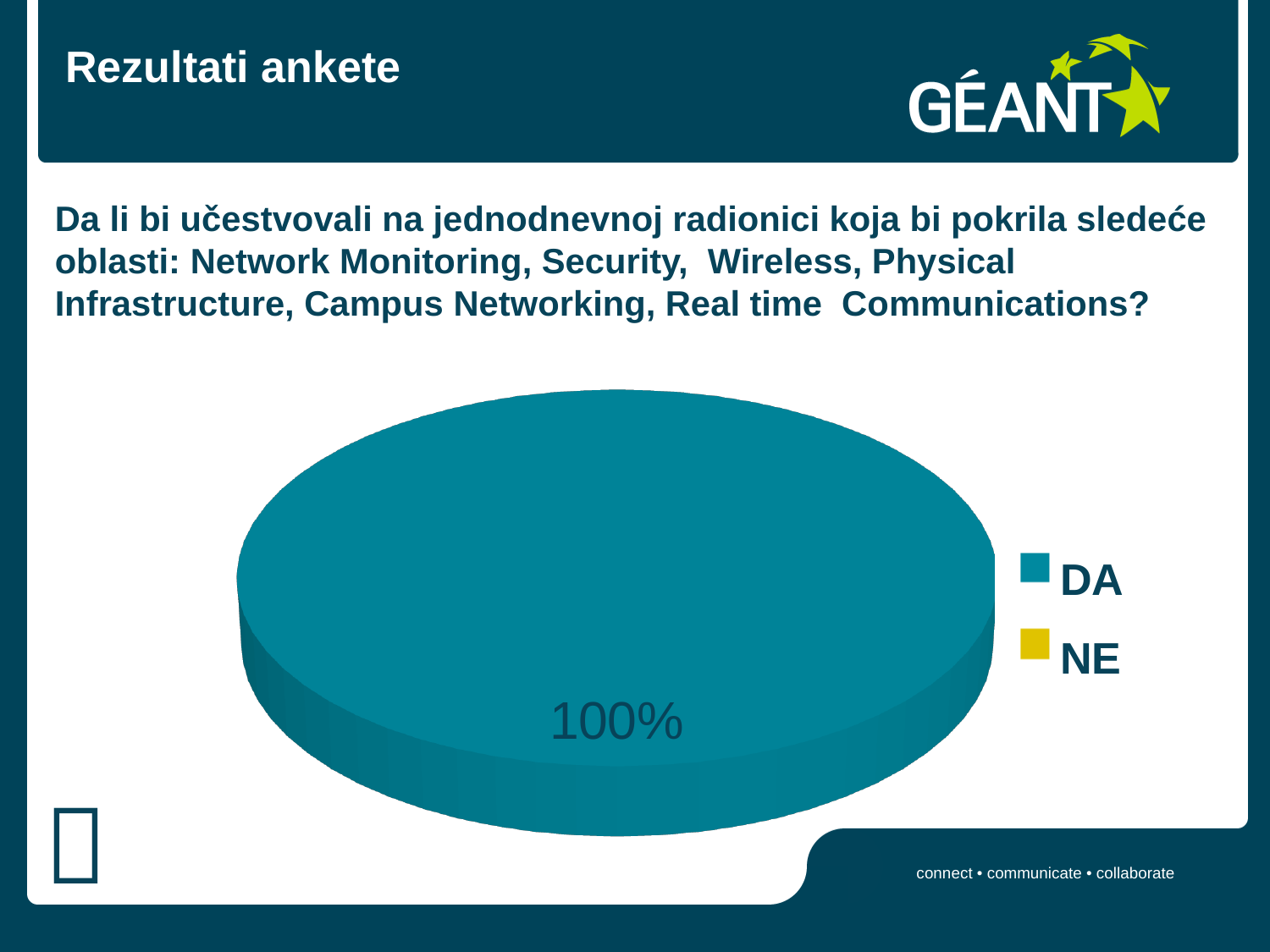
What colour is used for the NE category in the legend? yellow Which category has the largest share of the pie? DA What share of the pie does the DA category have? 100% Which is larger, the share for DA or the share for NE? DA What kind of chart is shown on the slide? pie chart How many categories does the legend list? 2 What percentage label is printed on the pie? 100% What colour is used for the DA category in the legend? teal Which category has the smallest share of the pie? NE